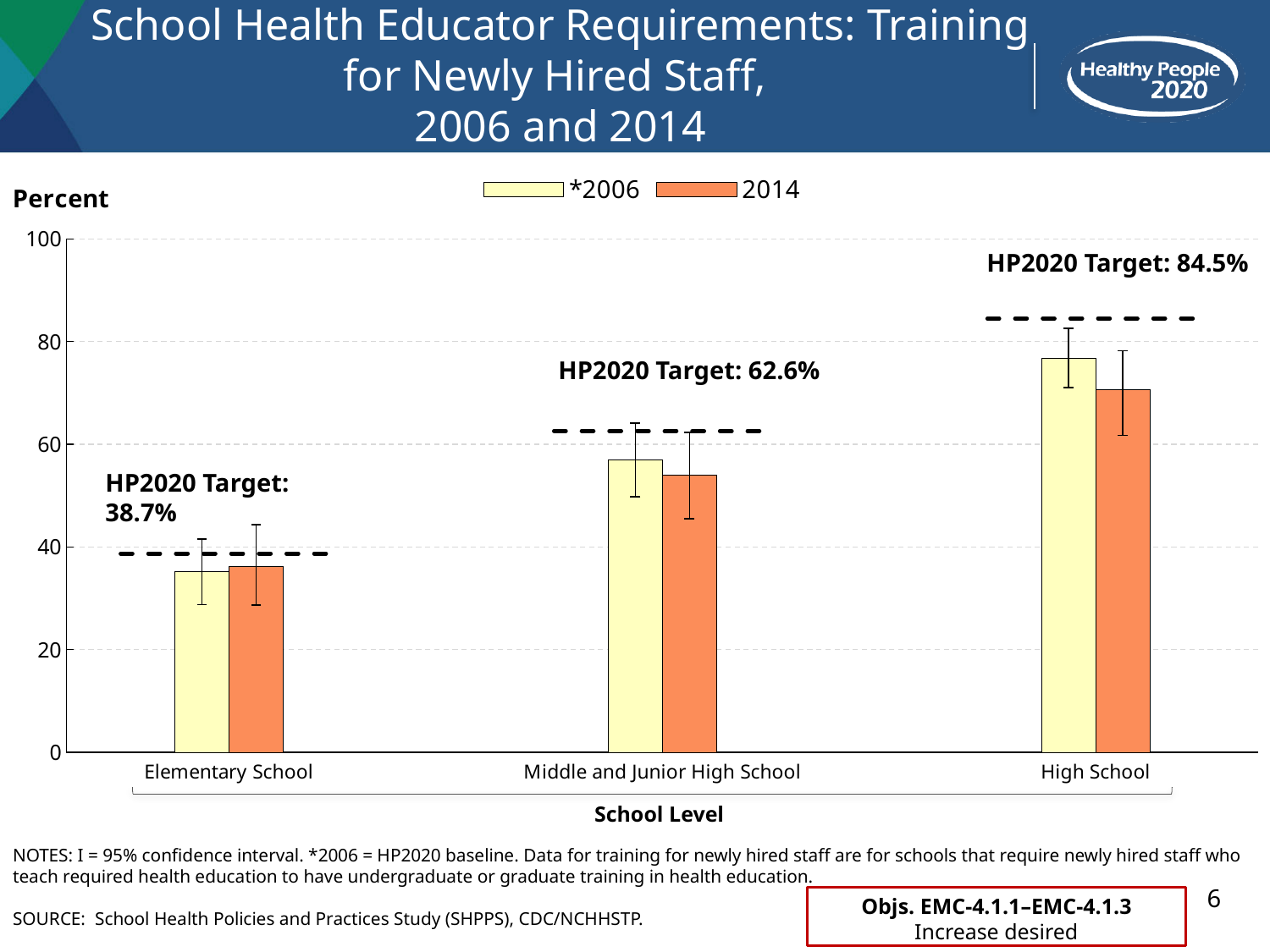
Is the 2014 value for High School greater or less than 80? less Is the 2006 value for High School greater or less than 60? greater For High School, which is larger, the 2006 value or the 2014 value? 2006 How many school levels are shown on the x axis? 3 Is the 2014 value for Elementary School greater or less than 40? less What kind of chart is shown on the slide? bar chart What is the HP2020 target shown for High School? 84.5% Do the 2006 values rise or fall moving from Elementary School to High School along the x axis? rise How many series does the legend list? 2 Which school level has the lowest 2006 value? Elementary School Which school level has the highest 2014 value? High School